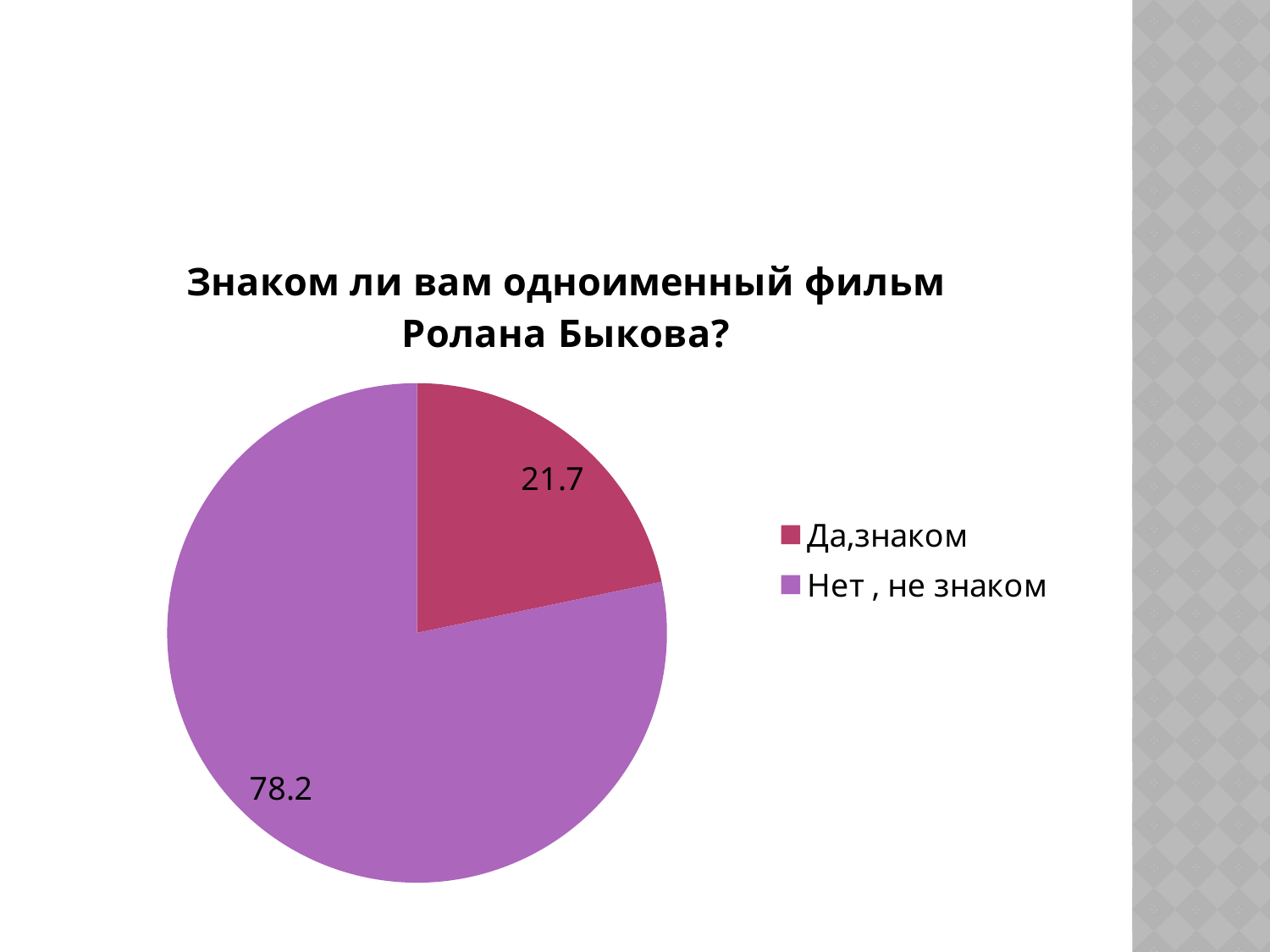
Which is larger, the value for "Да,знаком" or the value for "Нет , не знаком"? Нет , не знаком What is the title of the chart? Знаком ли вам одноименный фильм Ролана Быкова? What kind of chart is shown on the slide? pie chart What is the value for "Нет , не знаком"? 78.2 Which category has the largest slice? Нет , не знаком How many entries does the legend list? 2 What is the difference between the values for "Нет , не знаком" and "Да,знаком"? 56.5 What is the value for "Да,знаком"? 21.7 What colour is the slice for "Да,знаком"? dark red How many categories does the pie chart have? 2 Which category has the smallest slice? Да,знаком